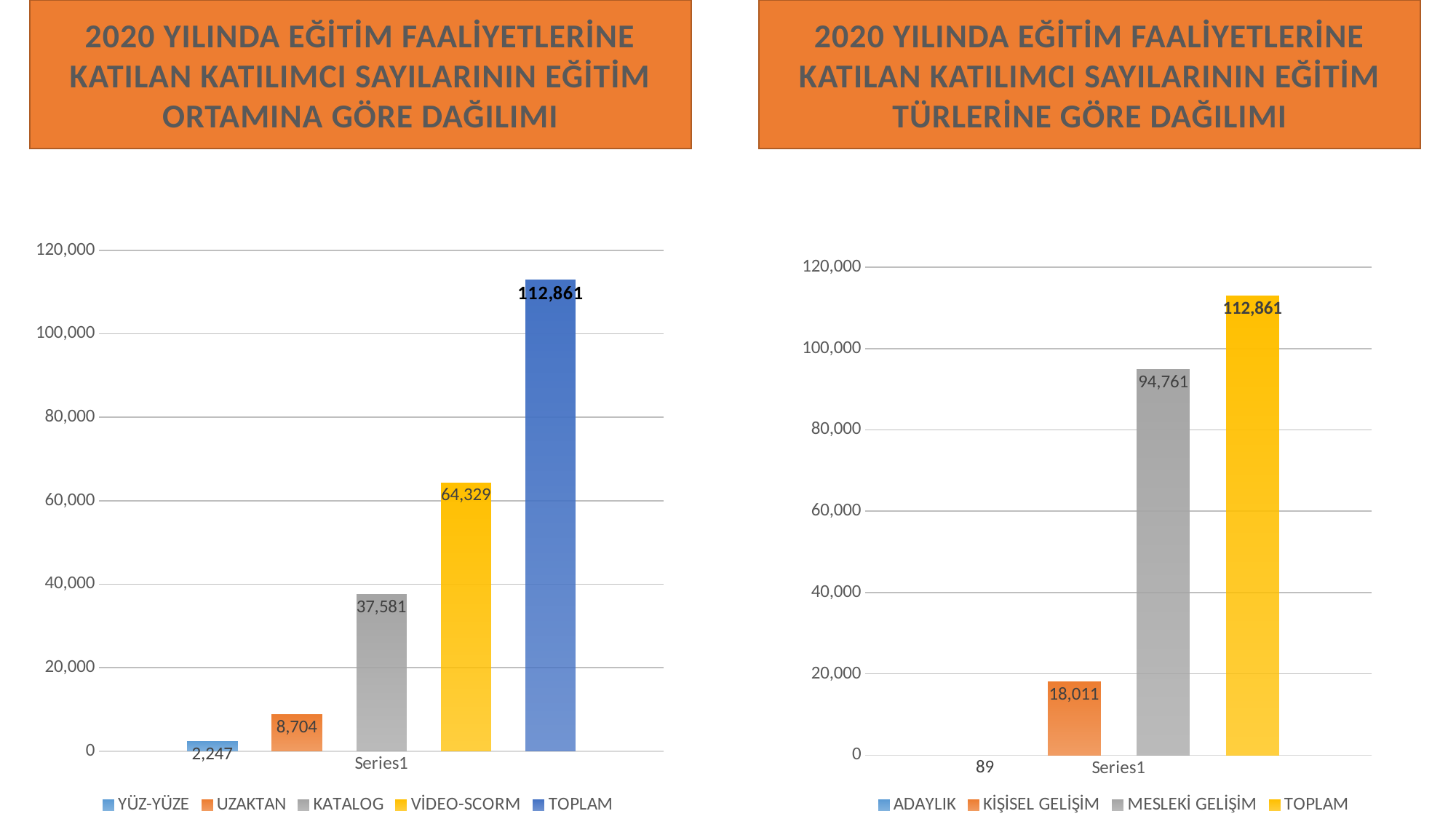
On the left chart, what is the difference between the VİDEO-SCORM and KATALOG values? 26,748 On the right chart, what colour is the TOPLAM bar? yellow What kind of chart is the right chart? bar chart On the left chart, what is the value for KATALOG? 37,581 On the left chart, which legend entry other than TOPLAM has the lowest value? YÜZ-YÜZE On the right chart, what is the value for ADAYLIK? 89 On the right chart, is the value for KİŞİSEL GELİŞİM greater or less than 20,000? less On the right chart, what is the value for MESLEKİ GELİŞİM? 94,761 On the left chart, how many legend entries are listed? 5 On the right chart, what is the difference between the TOPLAM and MESLEKİ GELİŞİM values? 18,100 On the left chart, what is the value for VİDEO-SCORM? 64,329 On the left chart, which is larger, UZAKTAN or YÜZ-YÜZE? UZAKTAN